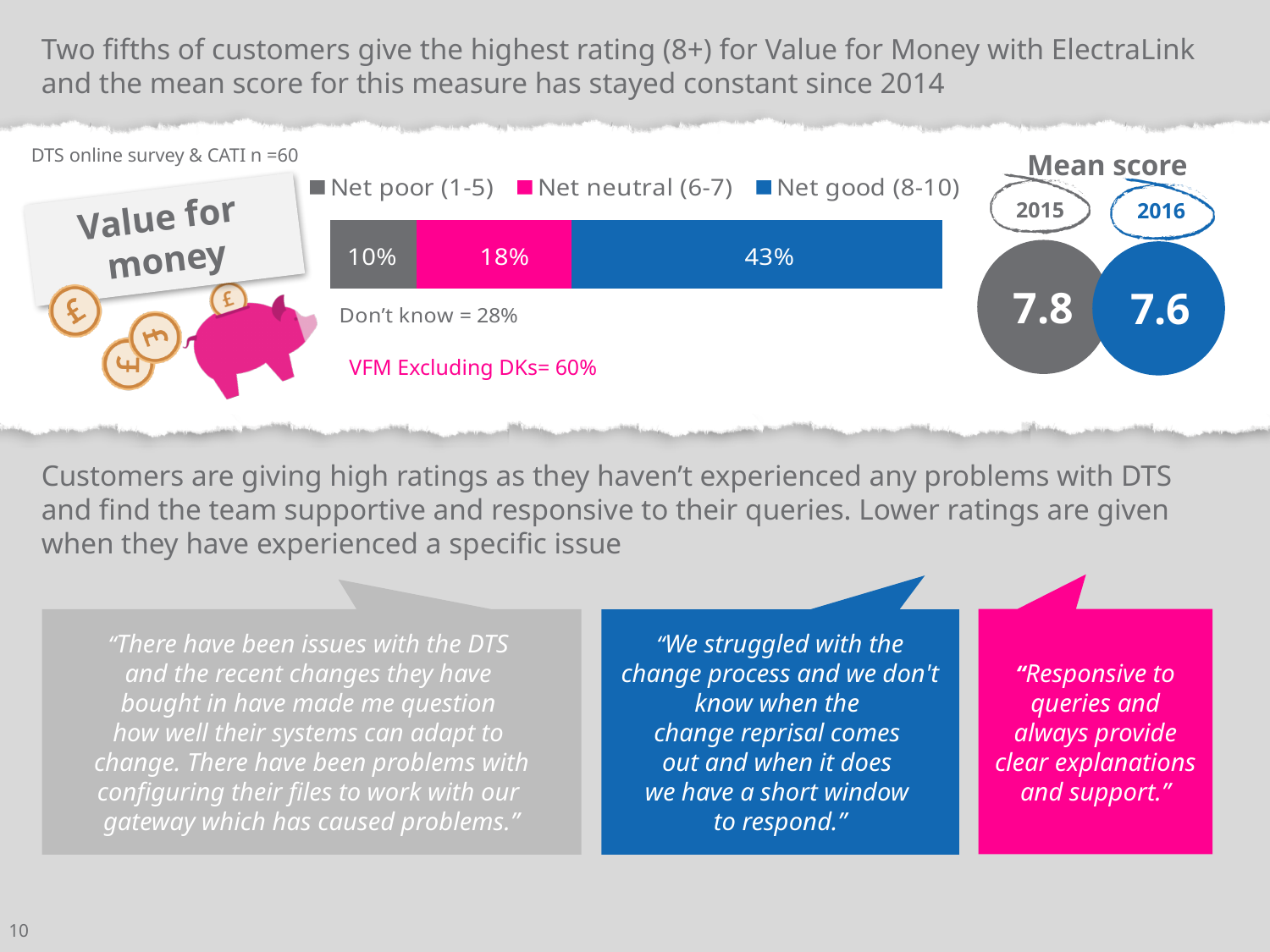
What is the difference in percentage points between the Net good (8-10) and Net neutral (6-7) segments? 25 percentage points What colour is used for the Net neutral (6-7) segment in the chart? Pink What percentage of customers gave a Net neutral (6-7) rating for Value for money? 18% What colour is used for the Net good (8-10) segment in the chart? Blue What kind of chart is used to show the Value for money ratings? Stacked bar chart Which rating category has the smallest segment in the Value for money bar? Net poor (1-5) What percentage of customers gave a Net poor (1-5) rating for Value for money? 10% What percentage of customers gave a Net good (8-10) rating for Value for money? 43% Which rating category has the largest segment in the Value for money bar? Net good (8-10) What is the total of the three segments shown in the Value for money bar? 71% Which is larger, the Net neutral (6-7) segment or the Net poor (1-5) segment? Net neutral (6-7) How many series does the legend of the Value for money chart list? 3